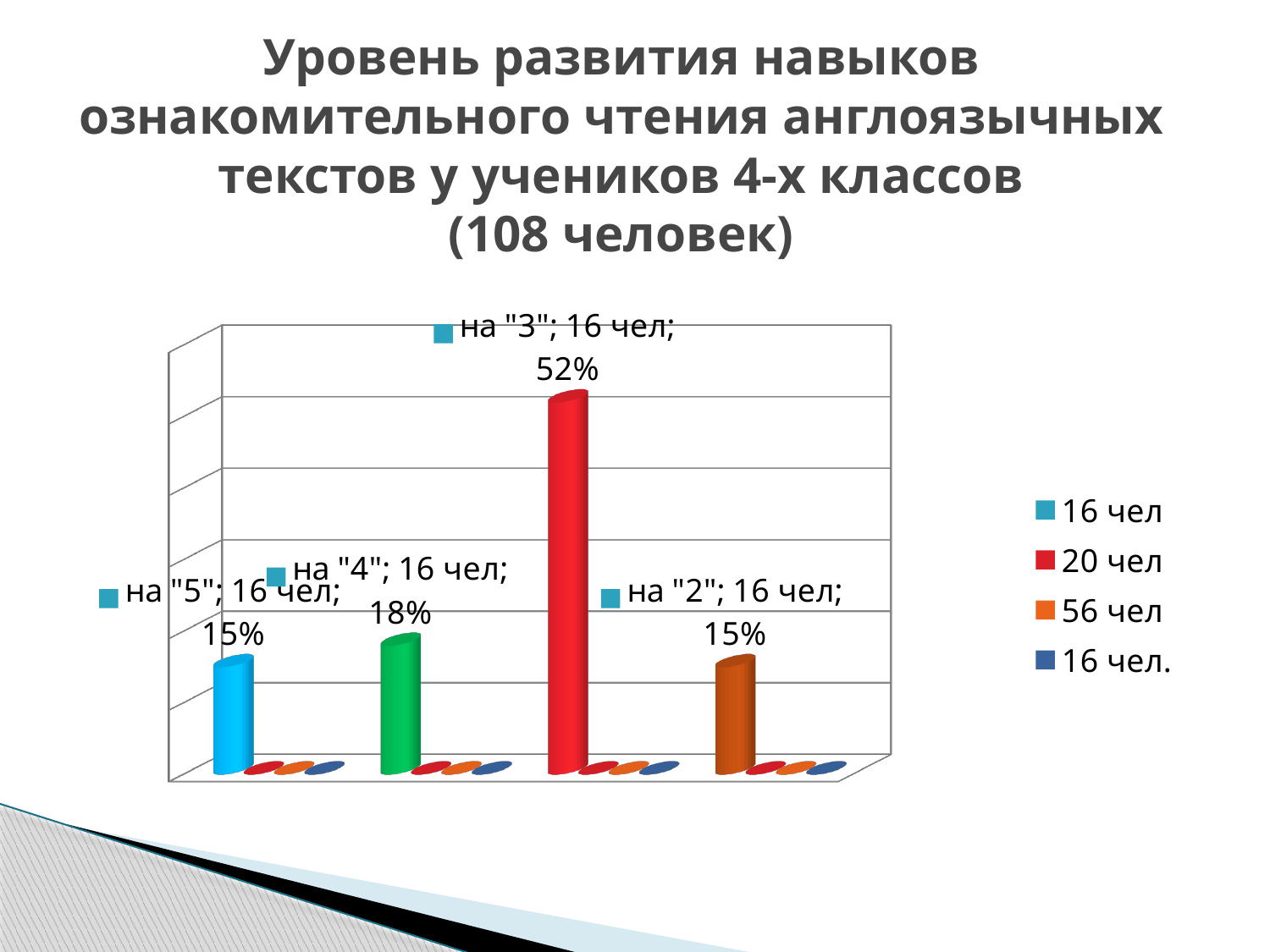
Which has the larger percentage, на "4" or на "5"? на "4" What percentage is shown for the category на "4"? 18% What is the difference in percentage points between на "3" and на "4"? 34 What percentage is shown for the category на "2"? 15% How many entries does the legend list? 4 What percentage is shown for the category на "3"? 52% How many students (человек) does the chart title say were surveyed? 108 What percentage is shown for the category на "5"? 15% What kind of chart is shown on the slide? bar chart Which category has the highest percentage? на "3" How many categories are shown on the x axis of the chart? 4 What is the difference in percentage points between на "3" and на "2"? 37